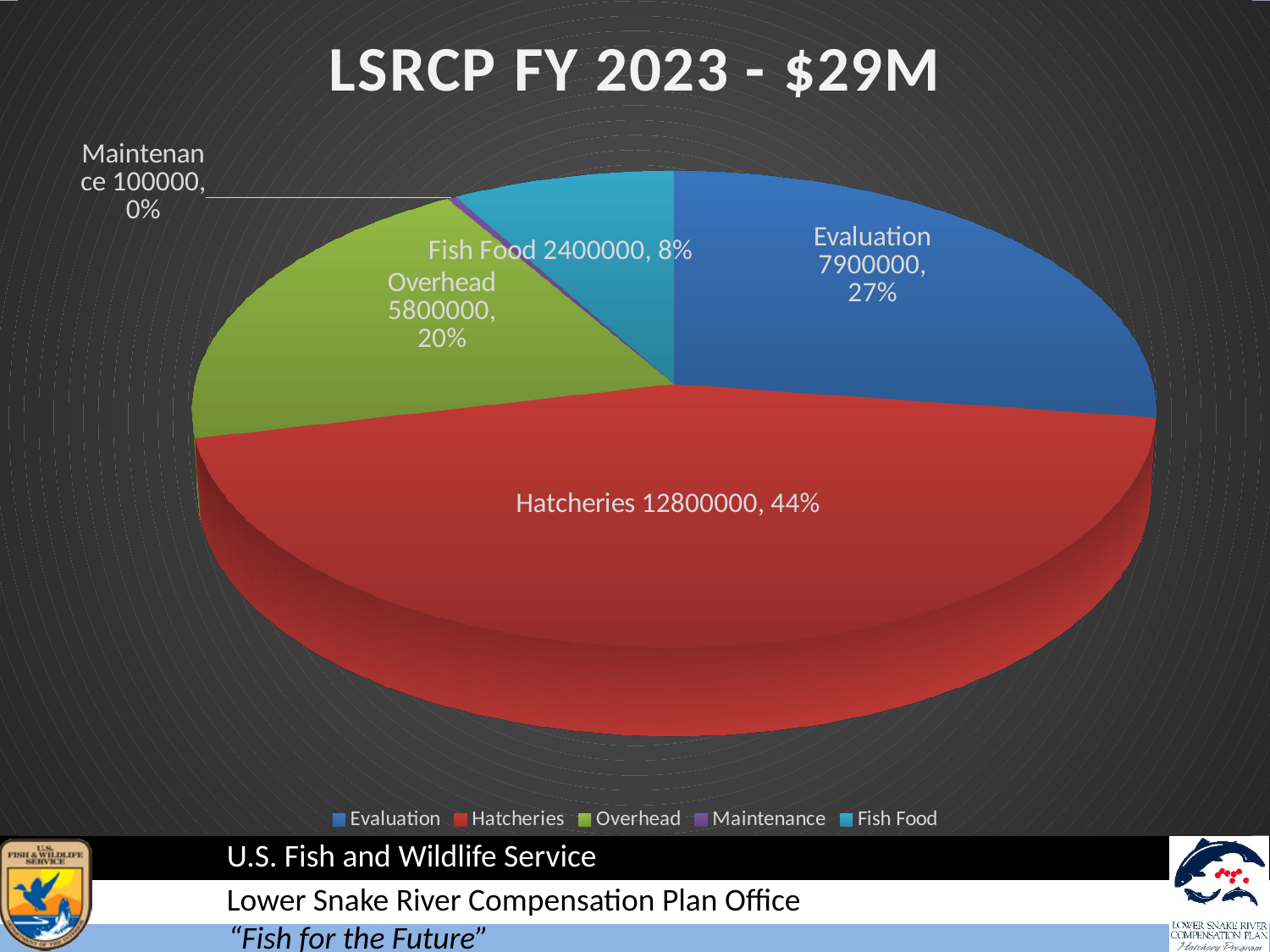
Which is larger, Overhead or Fish Food? Overhead What is the value for Evaluation? 7900000 How many categories does the pie chart show? 5 What is the difference between the Hatcheries and Evaluation values? 4900000 What is the value for Maintenance? 100000 What is the value for Hatcheries? 12800000 What is the value for Fish Food? 2400000 Which category has the smallest slice? Maintenance What share of the pie does Overhead represent? 20% What share of the pie does Evaluation represent? 27% What is the value for Overhead? 5800000 Which category has the largest slice? Hatcheries